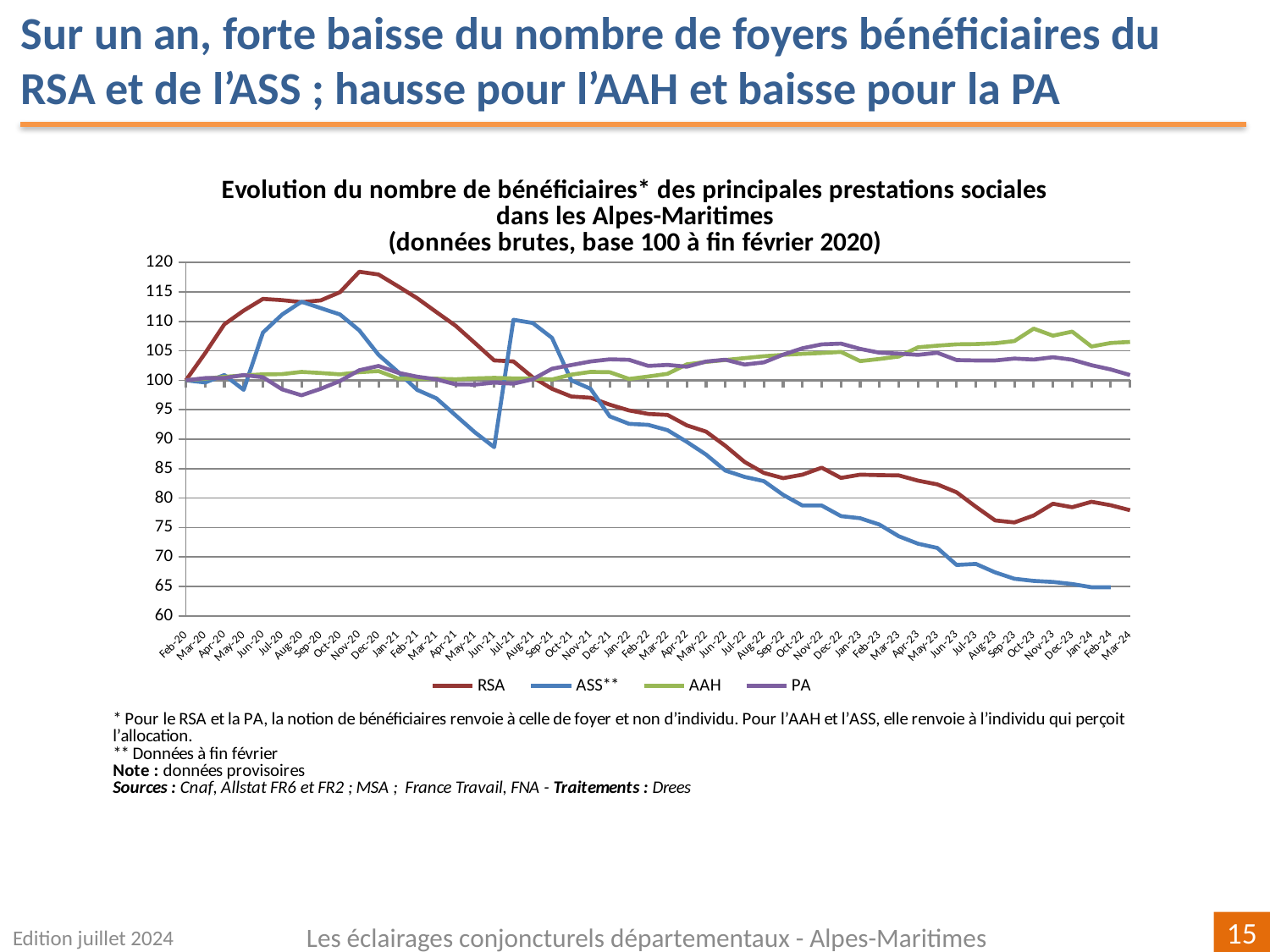
Is the value for RSA at Mar-24 greater or less than 75? greater What kind of chart is shown on the slide? line chart Is the value for ASS** at Jun-21 greater or less than 95? less Which series has the highest value at Mar-24? AAH At Mar-24, which is larger, AAH or PA? AAH How many series does the legend list? 4 Is the value for AAH at Mar-24 greater or less than 105? greater Which series has the lowest value at Mar-24? RSA Which series are listed in the legend? RSA, ASS**, AAH, PA